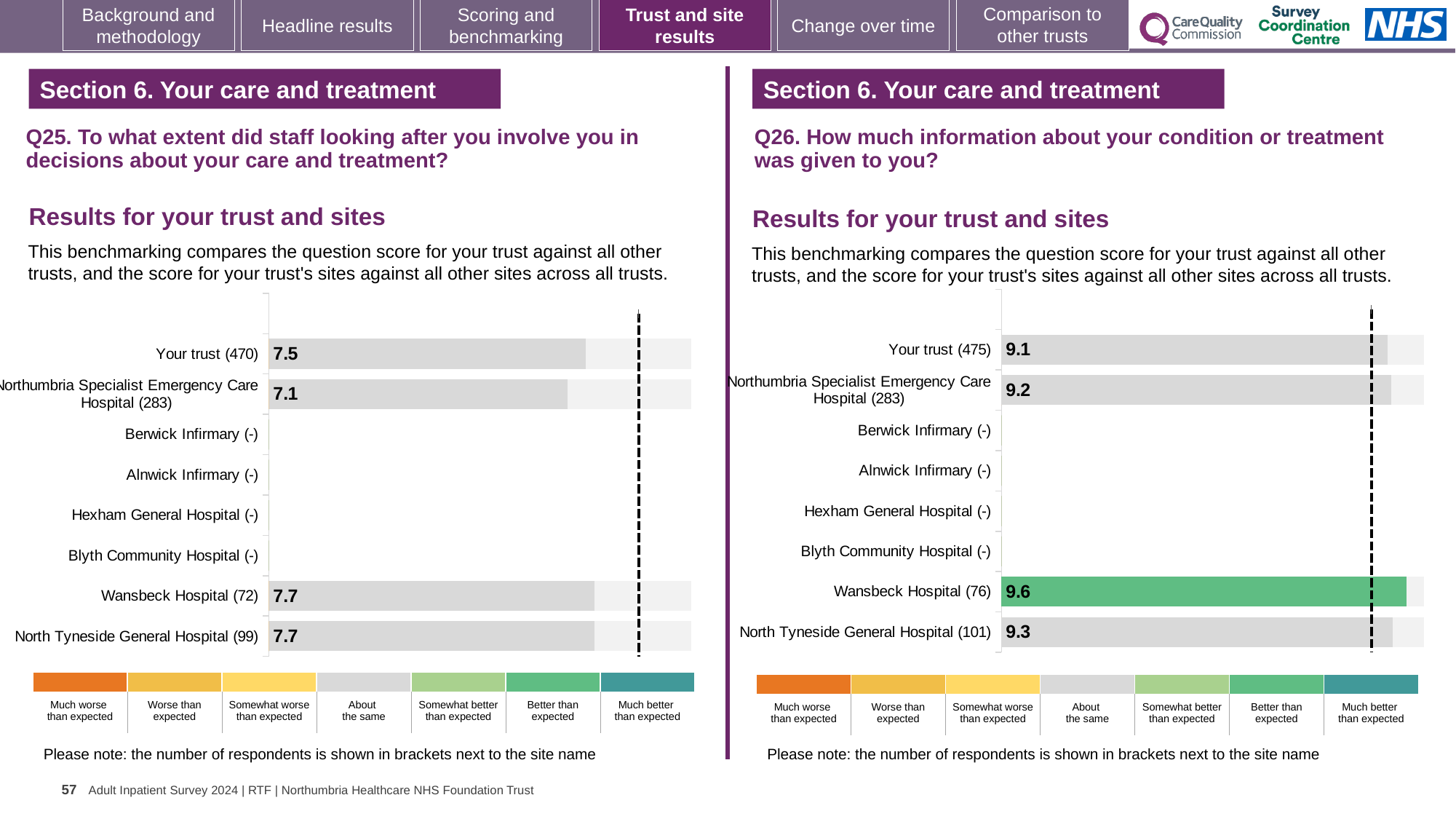
On the Q25 chart, what is the score for Your trust? 7.5 On the Q25 chart, what is the difference between the scores for Wansbeck Hospital and Northumbria Specialist Emergency Care Hospital? 0.6 How many respondents are shown in brackets for Your trust on the Q26 chart? 475 On the Q26 chart, what is the difference between the scores for Wansbeck Hospital and Your trust? 0.5 What kind of chart is used on the Q25 side of the slide? Bar chart On the Q26 chart, which site's bar is coloured green? Wansbeck Hospital On the Q25 chart, which site has the lowest score? Northumbria Specialist Emergency Care Hospital On the Q26 chart, which site has the highest score? Wansbeck Hospital On the Q25 chart, what is the score for Northumbria Specialist Emergency Care Hospital? 7.1 On the Q26 chart, which is larger: the score for Your trust or the score for Wansbeck Hospital? Wansbeck Hospital On the Q26 chart, what is the score for North Tyneside General Hospital? 9.3 On the Q26 chart, what is the score for Wansbeck Hospital? 9.6